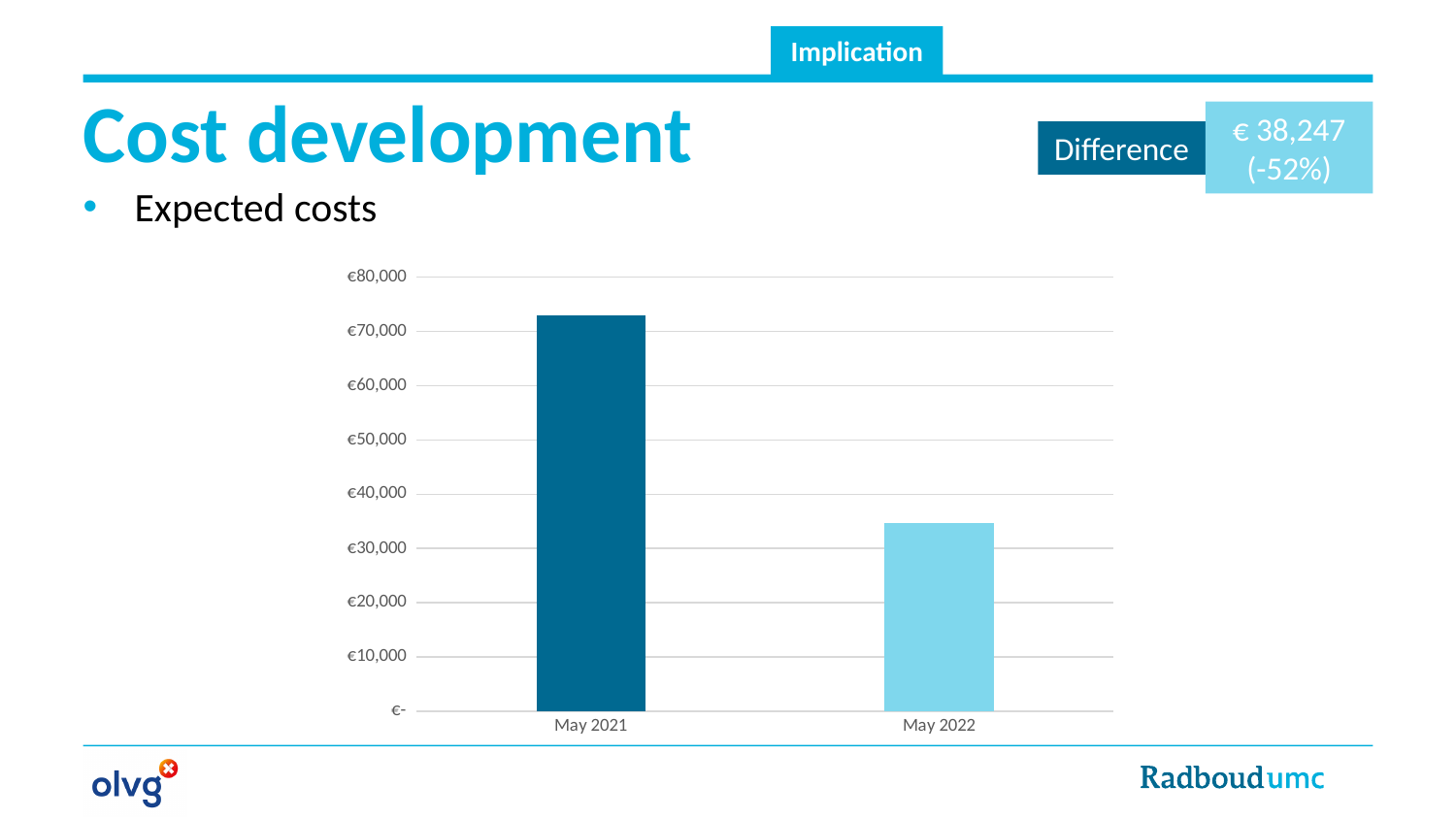
Is the value for May 2022 greater or less than €40,000? less Is the value for May 2022 greater or less than €30,000? greater Do the expected costs rise or fall from May 2021 to May 2022? fall Is the value for May 2021 greater or less than €60,000? greater What difference between the two periods does the slide state in the box next to the title? € 38,247 (-52%) What is the highest value shown on the y axis of the chart? €80,000 What kind of chart is shown on the slide? bar chart How many categories are plotted on the chart? 2 Which category has the lowest expected costs? May 2022 Which is larger, the value for May 2021 or the value for May 2022? May 2021 Which category has the highest expected costs? May 2021